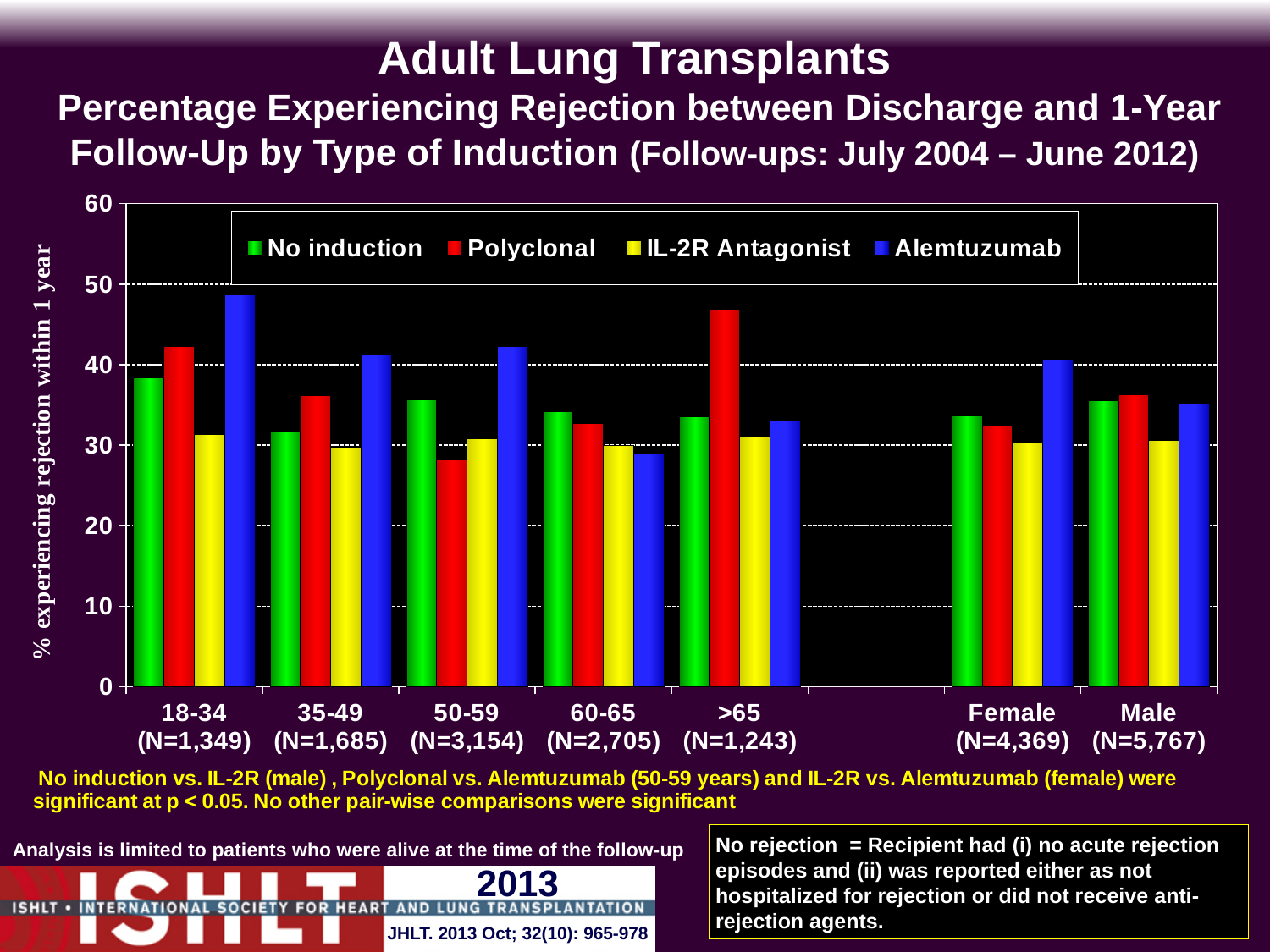
Is the Polyclonal value for the 50-59 age group greater or less than 30? less What kind of chart is shown on the slide? bar chart Is the Alemtuzumab value for the 18-34 age group greater or less than 40? greater In the 35-49 age group, which induction type has the highest value? Alemtuzumab What colour represents the Polyclonal series in the legend? red In the >65 age group, which is larger: the Polyclonal value or the No induction value? Polyclonal How many categories are shown along the x axis? 7 Is the Polyclonal value for the >65 age group greater or less than 40? greater In the 50-59 age group, which induction type has the lowest value? Polyclonal Which age group has the highest Alemtuzumab bar? 18-34 For Female recipients, which is larger: the Alemtuzumab value or the IL-2R Antagonist value? Alemtuzumab How many series does the legend list? 4